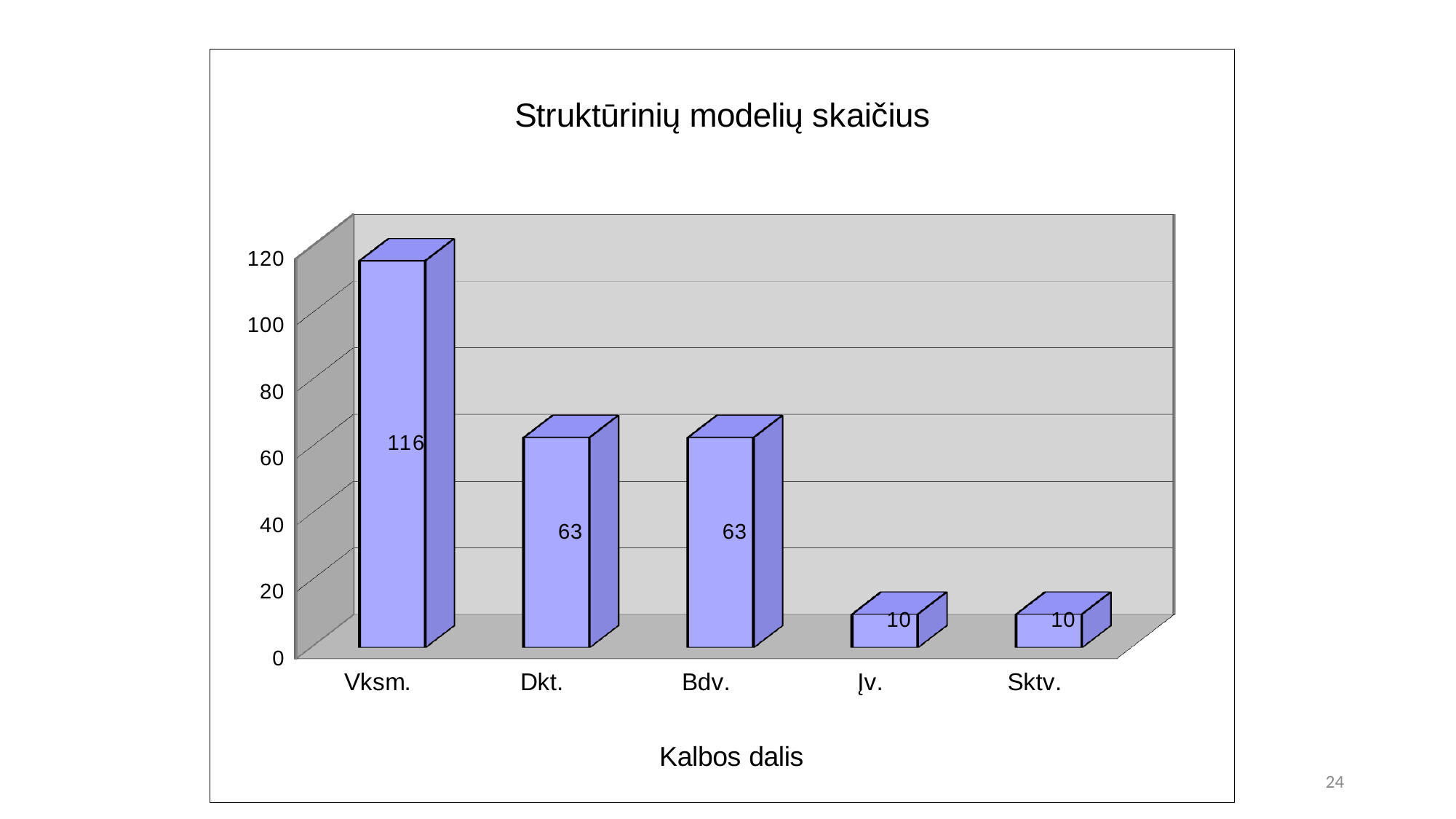
What is the difference between the values for Vksm. and Bdv.? 53 What is the title of the chart? Struktūrinių modelių skaičius How many categories are shown on the x axis? 5 What kind of chart is shown on the slide? bar chart Is the value for Vksm. greater or less than 100? greater What is the difference between the values for Dkt. and Įv.? 53 Is the value for Įv. greater or less than 20? less What is the value for Vksm.? 116 What is the value for Dkt.? 63 Which category has the highest value? Vksm. What is the value for Sktv.? 10 Which is larger, the value for Vksm. or the value for Dkt.? Vksm.